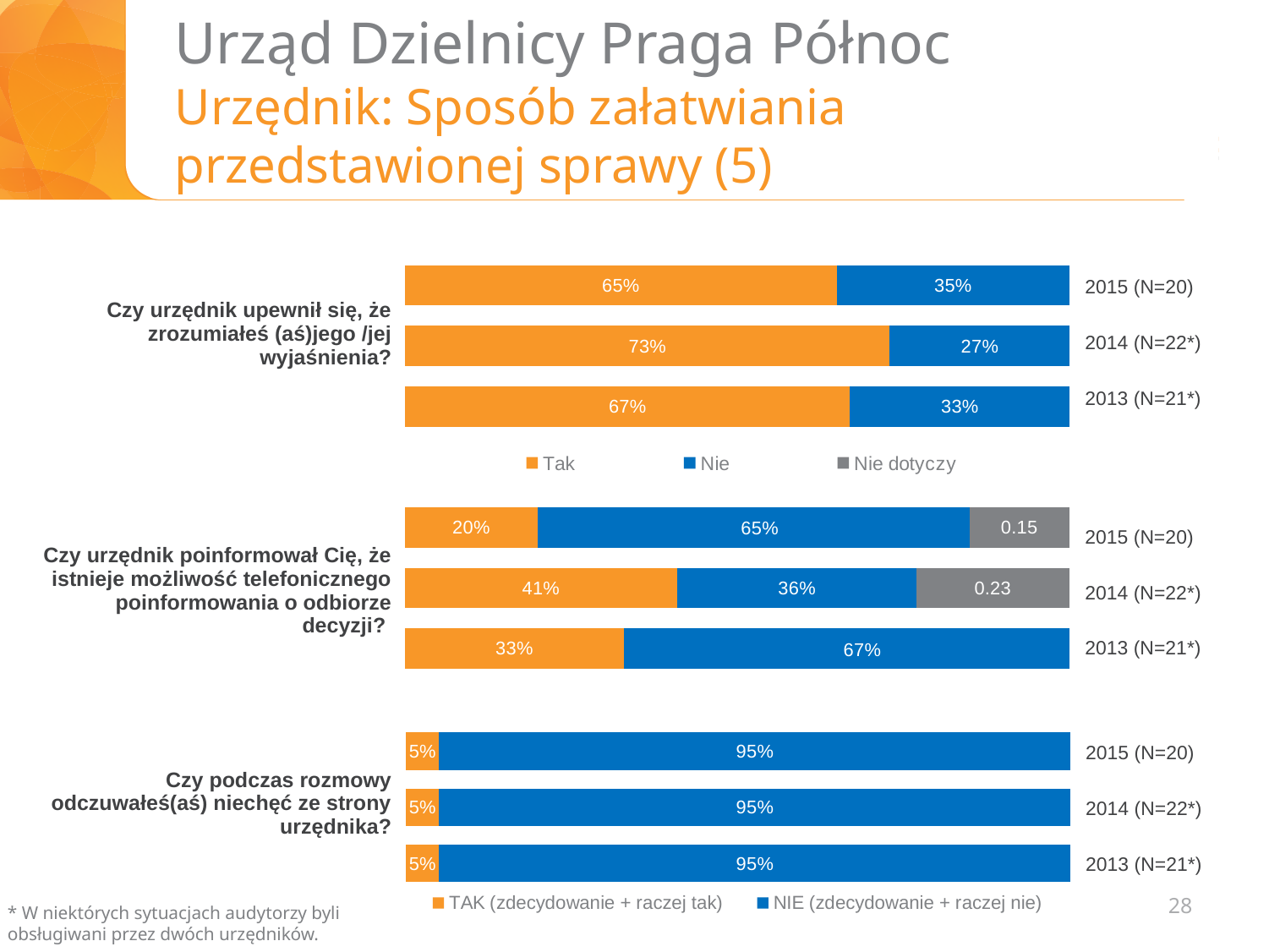
In the chart for "Czy urzędnik poinformował Cię, że istnieje możliwość telefonicznego poinformowania o odbiorze decyzji?", which year has the lowest Tak value? 2015 (N=20) In the chart for "Czy urzędnik upewnił się, że zrozumiałeś (aś) jego /jej wyjaśnienia?", what is the difference between the Tak values for 2014 (N=22*) and 2015 (N=20)? 8% In the chart for "Czy urzędnik upewnił się, że zrozumiałeś (aś) jego /jej wyjaśnienia?", what is the Nie value for 2014 (N=22*)? 27% In the chart for "Czy urzędnik upewnił się, że zrozumiałeś (aś) jego /jej wyjaśnienia?", what is the Tak value for 2015 (N=20)? 65% How many series does the legend of the chart for "Czy urzędnik upewnił się, że zrozumiałeś (aś) jego /jej wyjaśnienia?" list? 3 How many year bars are shown in the chart for "Czy podczas rozmowy odczuwałeś(aś) niechęć ze strony urzędnika?"? 3 In the chart for "Czy urzędnik poinformował Cię, że istnieje możliwość telefonicznego poinformowania o odbiorze decyzji?", is the Nie value for 2013 (N=21*) larger or smaller than the Nie value for 2014 (N=22*)? larger What type of chart is used for "Czy podczas rozmowy odczuwałeś(aś) niechęć ze strony urzędnika?"? Stacked bar chart In the chart for "Czy urzędnik poinformował Cię, że istnieje możliwość telefonicznego poinformowania o odbiorze decyzji?", what is the Nie dotyczy value for 2014 (N=22*)? 0.23 In the chart for "Czy urzędnik poinformował Cię, że istnieje możliwość telefonicznego poinformowania o odbiorze decyzji?", what is the Tak value for 2015 (N=20)? 20% In the chart for "Czy podczas rozmowy odczuwałeś(aś) niechęć ze strony urzędnika?", what is the NIE (zdecydowanie + raczej nie) value for 2013 (N=21*)? 95% In the chart for "Czy urzędnik upewnił się, że zrozumiałeś (aś) jego /jej wyjaśnienia?", which year has the highest Tak value? 2014 (N=22*)